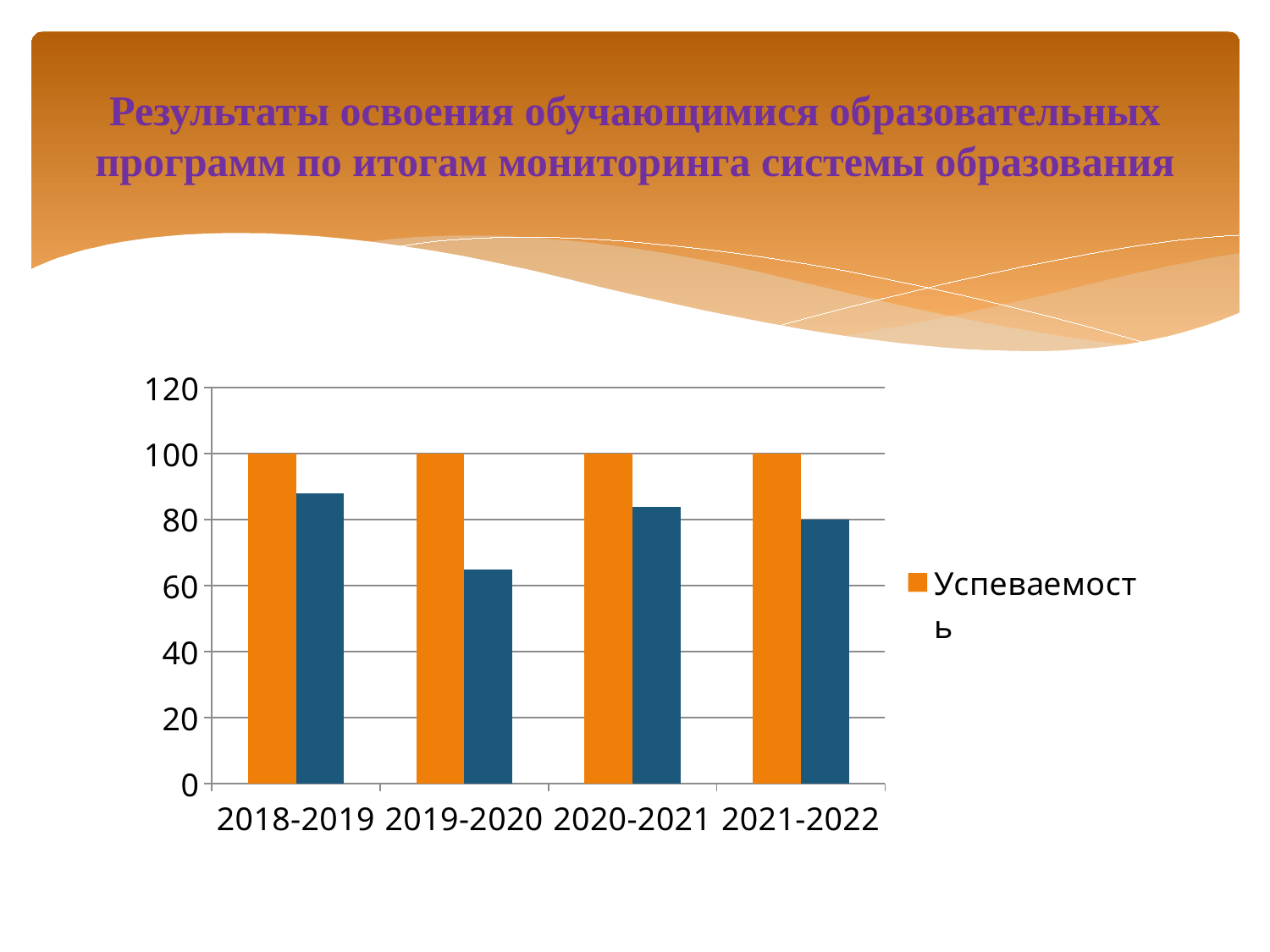
Is the value of the dark blue bar for 2019-2020 greater or less than 60? greater For 2020-2021, which is larger: the Успеваемость bar or the dark blue bar? Успеваемость What colour are the Успеваемость bars? Orange Is the value of the dark blue bar for 2019-2020 greater or less than 80? less Is the value of the dark blue bar for 2018-2019 greater or less than 80? greater What is the value of Успеваемость for 2018-2019? 100 Does the Успеваемость series rise, fall or stay the same across the school years? Stays the same In which school year is the dark blue bar the lowest? 2019-2020 What kind of chart is shown on the slide? Bar chart How many series does the legend list? 1 How many school-year categories are shown on the x axis? 4 What is the value of Успеваемость for 2021-2022? 100